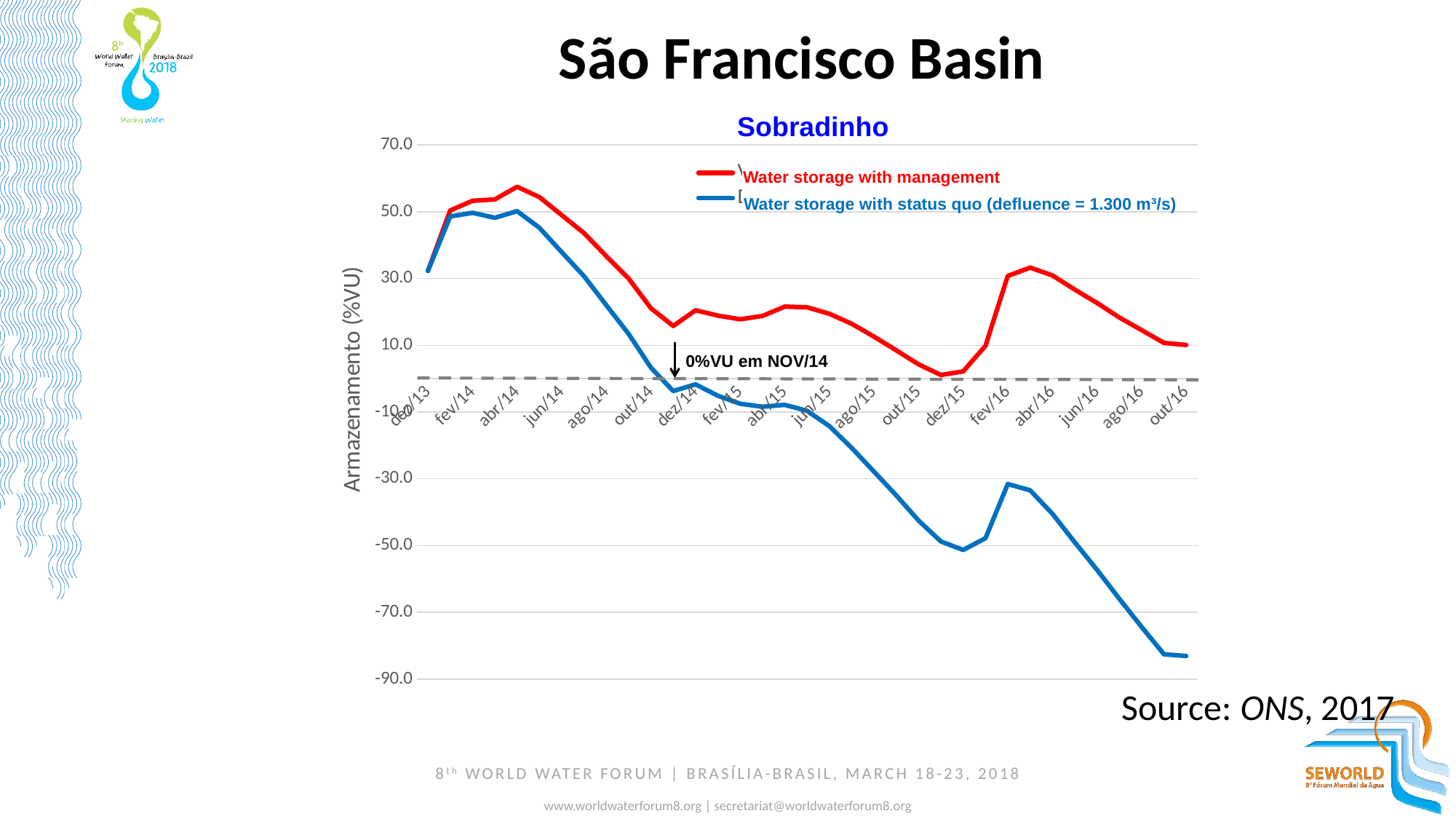
Which series reaches the lowest value on the chart? Water storage with status quo (defluence = 1.300 m³/s) Is the value for 'Water storage with status quo' at out/16 greater or less than -70.0? less Is the value for 'Water storage with status quo' at dez/15 greater or less than -30.0? less What is the title of the chart? Sobradinho Is the value for 'Water storage with management' at abr/14 greater or less than 40.0? greater What kind of chart is shown on the slide? line chart What is the label of the vertical axis? Armazenamento (%VU) How many month labels are shown on the x axis? 18 Does the 'Water storage with status quo' line rise or fall between fev/16 and out/16? fall How many series does the legend list? 2 At out/16, which series has the higher value: 'Water storage with management' or 'Water storage with status quo'? Water storage with management